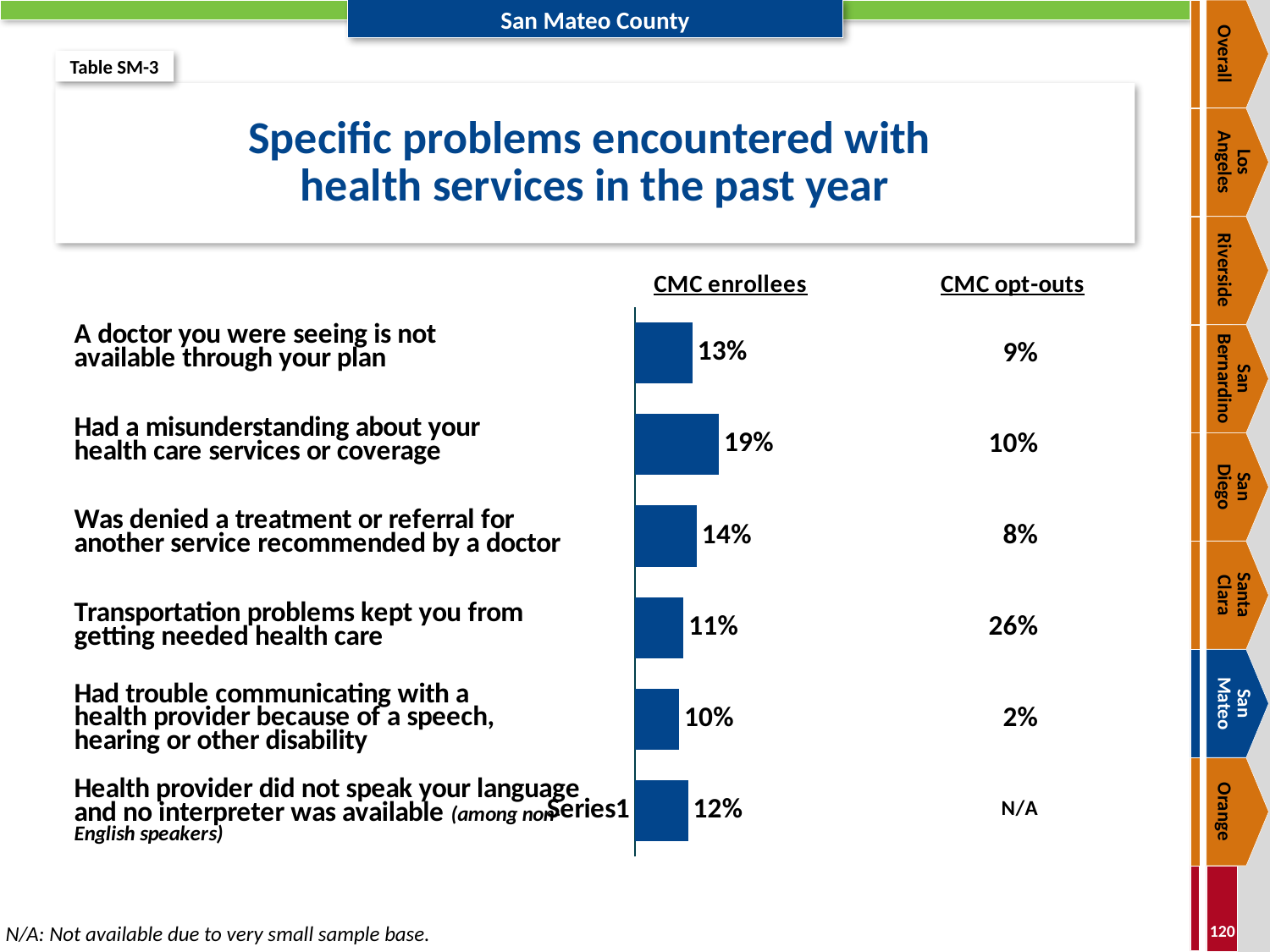
What percentage of CMC enrollees had a misunderstanding about their health care services or coverage? 19% What percentage of CMC enrollees had trouble communicating with a health provider because of a speech, hearing or other disability? 10% What kind of chart is shown on the slide? bar chart Among CMC enrollees, which is larger: the percentage denied a treatment or referral, or the percentage with transportation problems? Was denied a treatment or referral for another service recommended by a doctor What is the difference in percentage points between the highest and lowest CMC enrollee values in the chart? 9 percentage points What percentage of CMC opt-outs reported transportation problems kept them from getting needed health care? 26% How many problem categories are plotted as bars in the chart? 6 Which problem has the lowest percentage among CMC enrollees? Had trouble communicating with a health provider because of a speech, hearing or other disability Which problem has the highest percentage among CMC enrollees? Had a misunderstanding about your health care services or coverage What value is shown for CMC opt-outs for 'Health provider did not speak your language and no interpreter was available'? N/A What is the title of the chart? Specific problems encountered with health services in the past year What percentage of CMC enrollees said a doctor they were seeing is not available through their plan? 13%